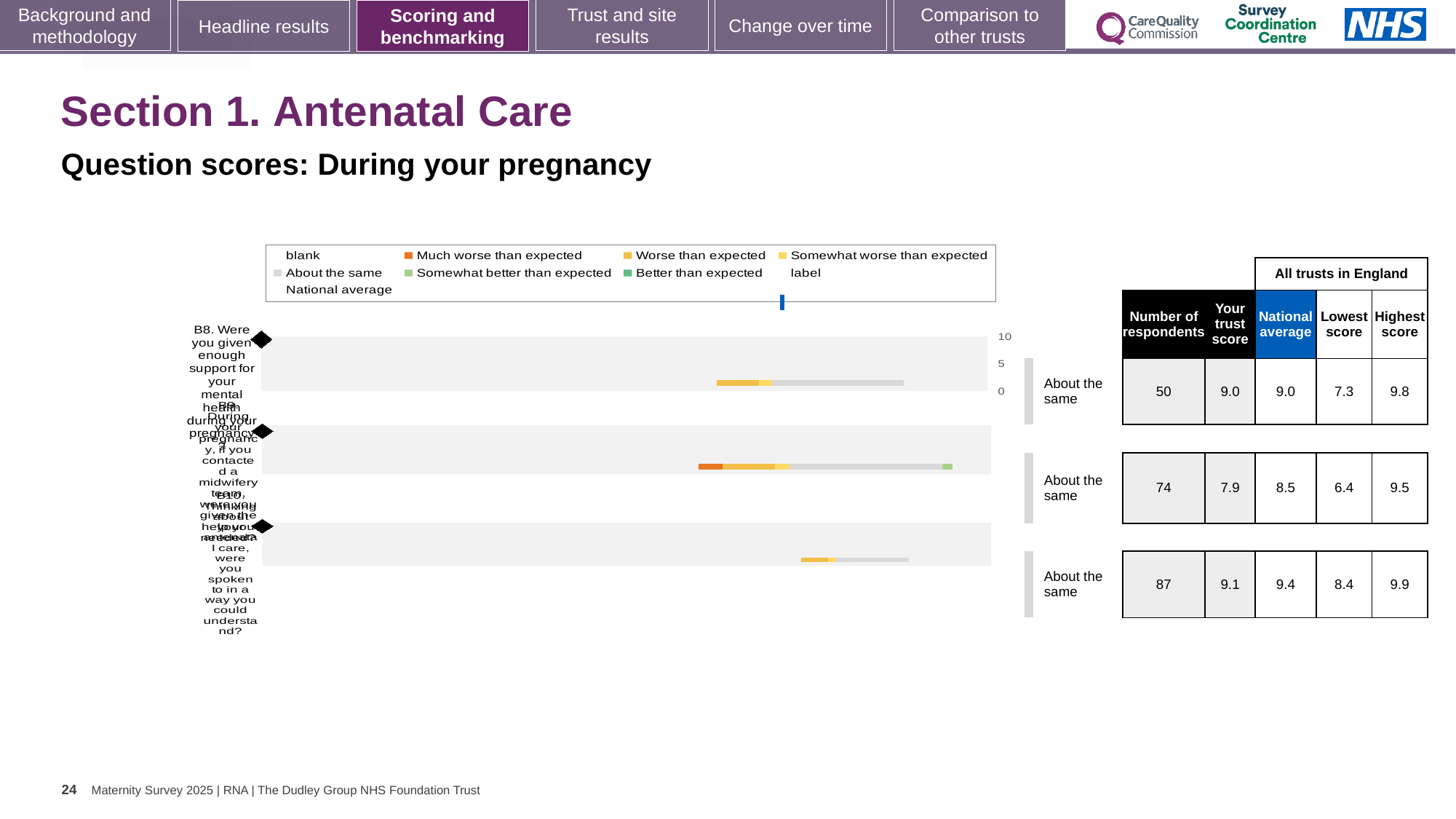
What colour does the legend use for "Better than expected"? green Which row has the lowest value in the "Lowest score" column? the second row (6.4) What kind of chart is shown on the slide? bar chart For the second row, which is larger: the trust score (7.9) or the national average (8.5)? national average What is the highest tick value shown on the chart's axis? 10 How many question rows (bars) does the chart show? 3 Which row has the highest number of respondents in the table beside the chart? the third row (87) In the table beside the chart, how many respondents are listed for the first row (B8)? 50 What benchmark category is shown next to each of the three rows of the chart? About the same In the table beside the chart, what is the "Your trust score" for the first row (B8, support for your mental health during pregnancy)? 9.0 For the third row, what is the difference between the highest score (9.9) and the lowest score (8.4)? 1.5 In the table beside the chart, what is the national average for the third row? 9.4